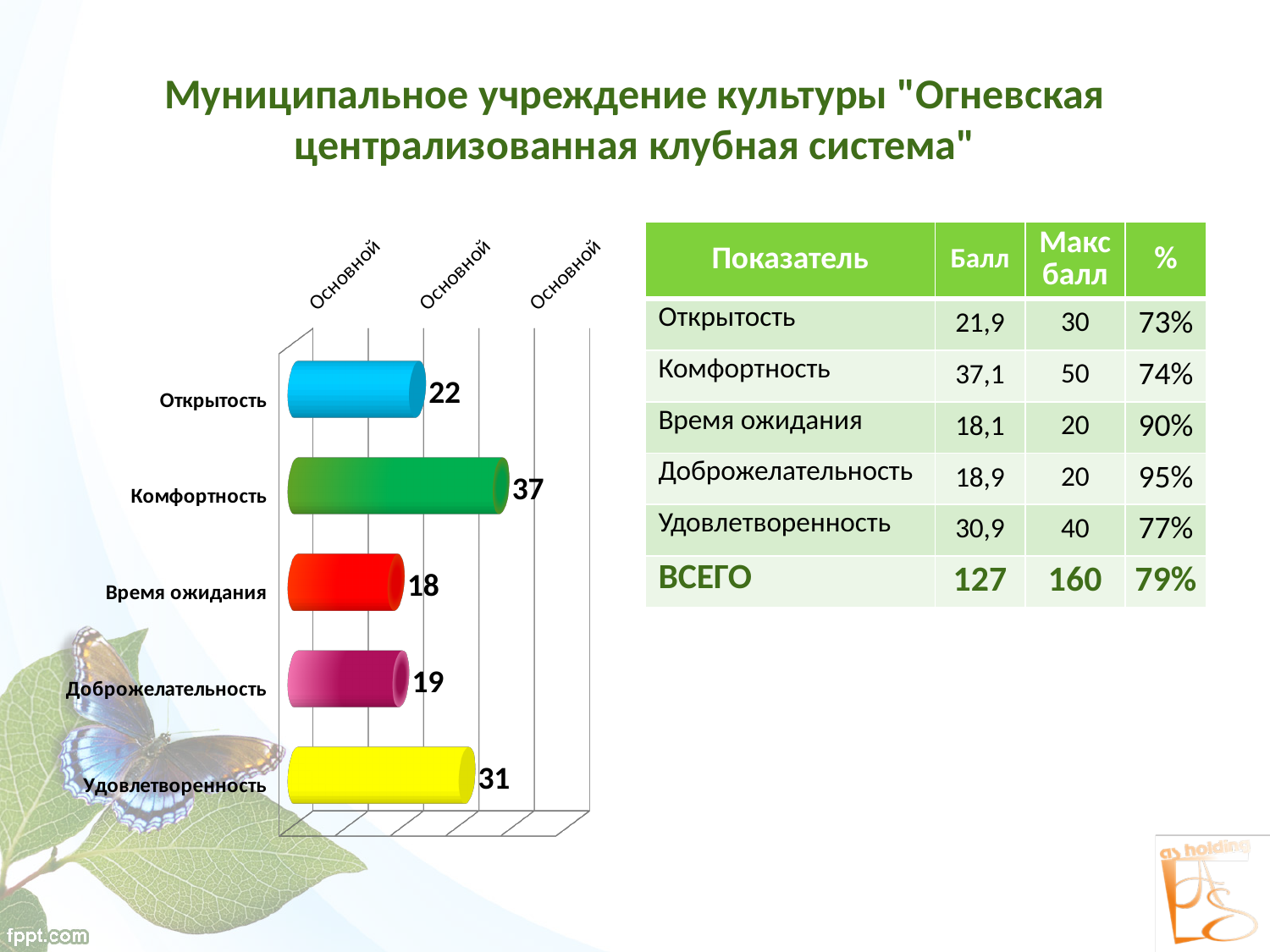
Which has a larger value in the bar chart, Открытость or Доброжелательность? Открытость What is the value shown for Время ожидания in the bar chart? 18 What is the value shown for Открытость in the bar chart? 22 What is the value shown for Доброжелательность in the bar chart? 19 How many categories does the bar chart show? 5 What is the value shown for Удовлетворенность in the bar chart? 31 Which category has the highest value in the bar chart? Комфортность Which category has the lowest value in the bar chart? Время ожидания What is the difference between the values for Комфортность and Удовлетворенность in the bar chart? 6 What is the value shown for Комфортность in the bar chart? 37 What colour is the bar for Удовлетворенность in the bar chart? Yellow What type of chart is shown on the slide? Bar chart